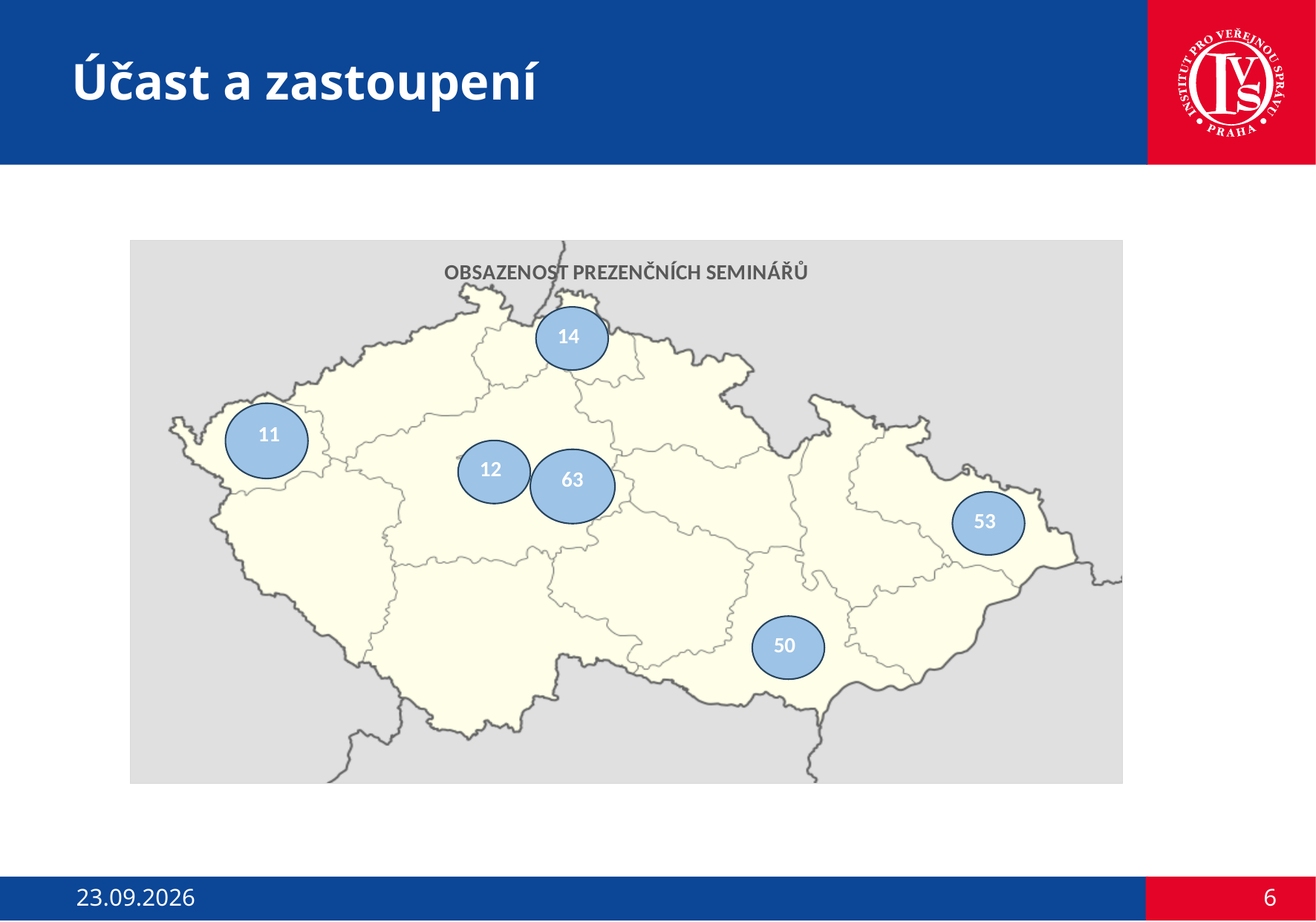
What kind of chart is shown on the slide? Map chart with bubbles Which is larger: the bubble value in the far east (53) or the bubble value in the south-east (50)? 53 How many bubbles (data points) are plotted on the map? 6 What is the title of the chart on the map? OBSAZENOST PREZENČNÍCH SEMINÁŘŮ What is the difference between the highest bubble value (63) and the lowest bubble value (11)? 52 What value is shown in the bubble in the far east of the map? 53 What is the total of all six bubble values on the map? 203 What value is shown in the bubble at the far west of the map? 11 What value is shown in the bubble at the northern edge of the map? 14 What is the highest value shown in any bubble on the map? 63 What value is shown in the bubble in the south-east of the map? 50 What is the lowest value shown in any bubble on the map? 11